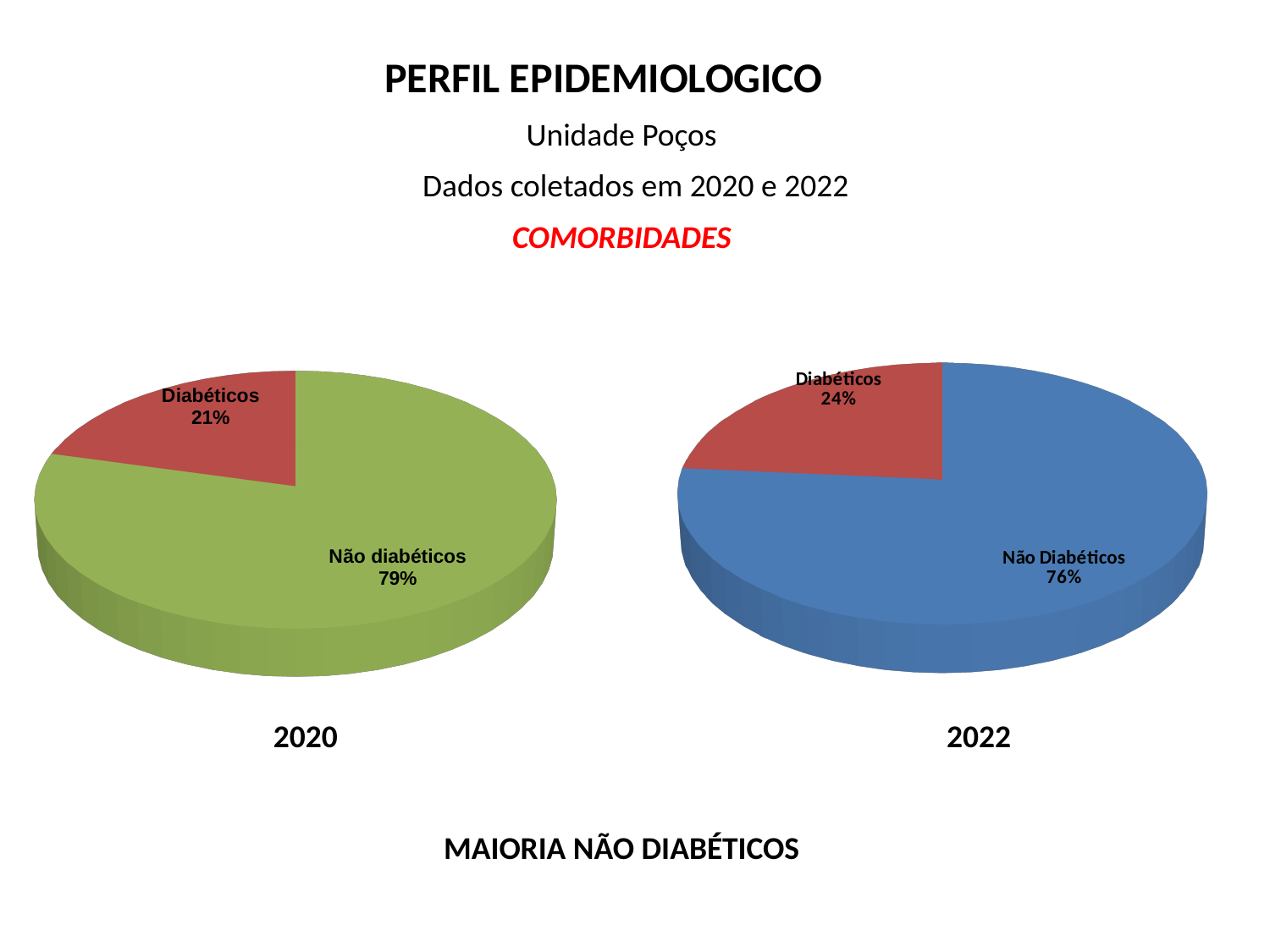
In the 2022 pie chart, what share is labelled for Não Diabéticos? 76% What is the label shown below the right-hand pie chart? 2022 Is the Diabéticos share larger in the 2020 pie chart or the 2022 pie chart? 2022 In the 2020 pie chart, what share is labelled for Não diabéticos? 79% In the 2022 pie chart, what share is labelled for Diabéticos? 24% What type of chart is the 2020 chart? Pie chart In the 2020 pie chart, what is the difference in percentage points between Não diabéticos and Diabéticos? 58 percentage points In the 2020 pie chart, what share is labelled for Diabéticos? 21% In the 2020 pie chart, which slice is the largest? Não diabéticos In the 2022 pie chart, which slice is the smallest? Diabéticos How many slices does the 2022 pie chart have? 2 In the 2020 pie chart, what colour is the Não diabéticos slice? Green